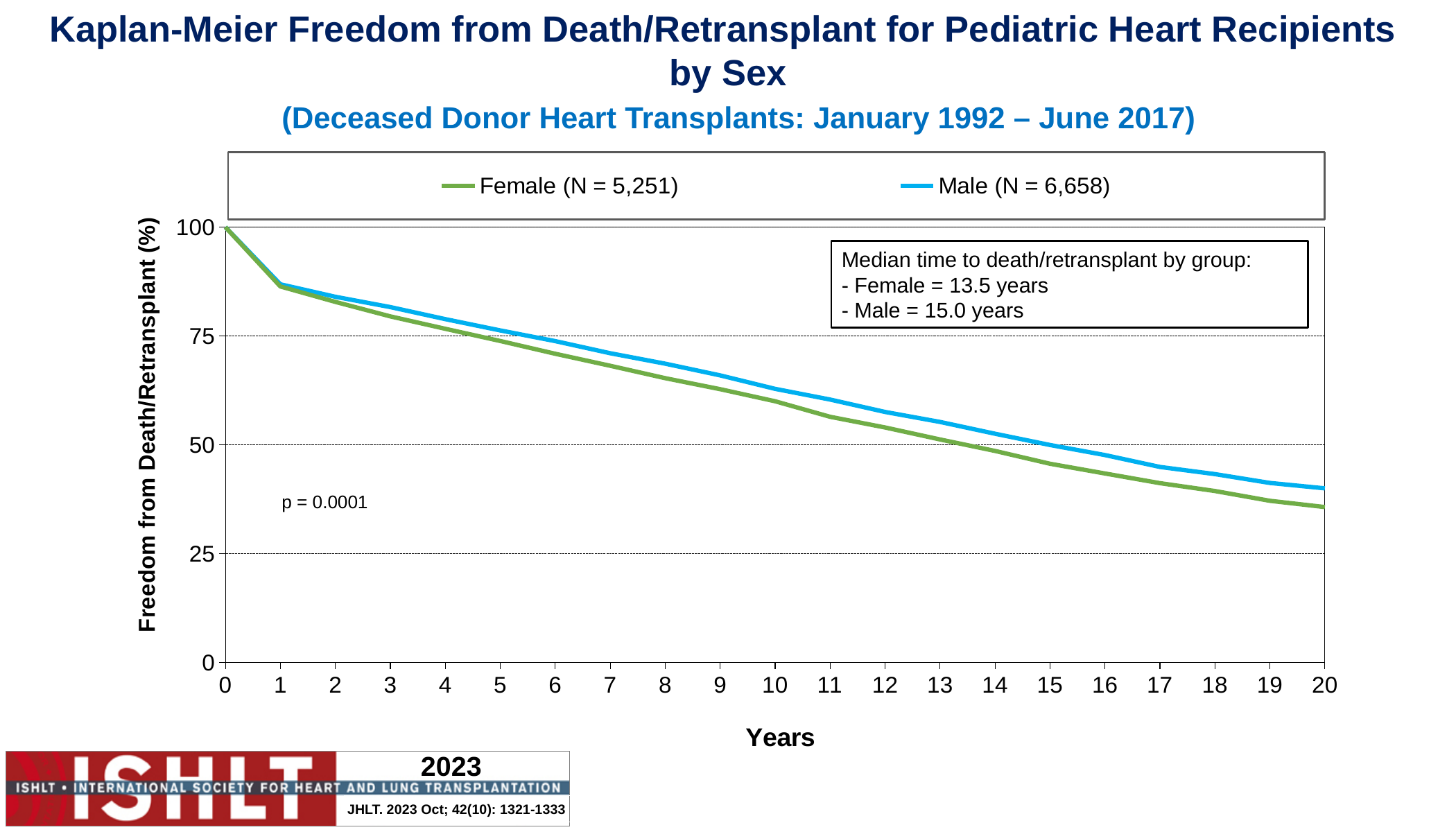
What is the N for the Female group shown in the legend? 5,251 What is the freedom from death/retransplant for both groups at year 0? 100 Is the value for Female at 10 years greater or less than 50? greater What is the median time to death/retransplant for the Male group? 15.0 years At 10 years, which curve is higher, Female or Male? Male Which group has the longer median time to death/retransplant, Female or Male? Male How many series does the legend list? 2 What kind of chart is shown on the slide? line chart What is the median time to death/retransplant for the Female group? 13.5 years Do the curves rise or fall as years increase? fall What is the difference between the median time to death/retransplant for Male and Female recipients? 1.5 years Is the value for Male at 20 years greater or less than 50? less